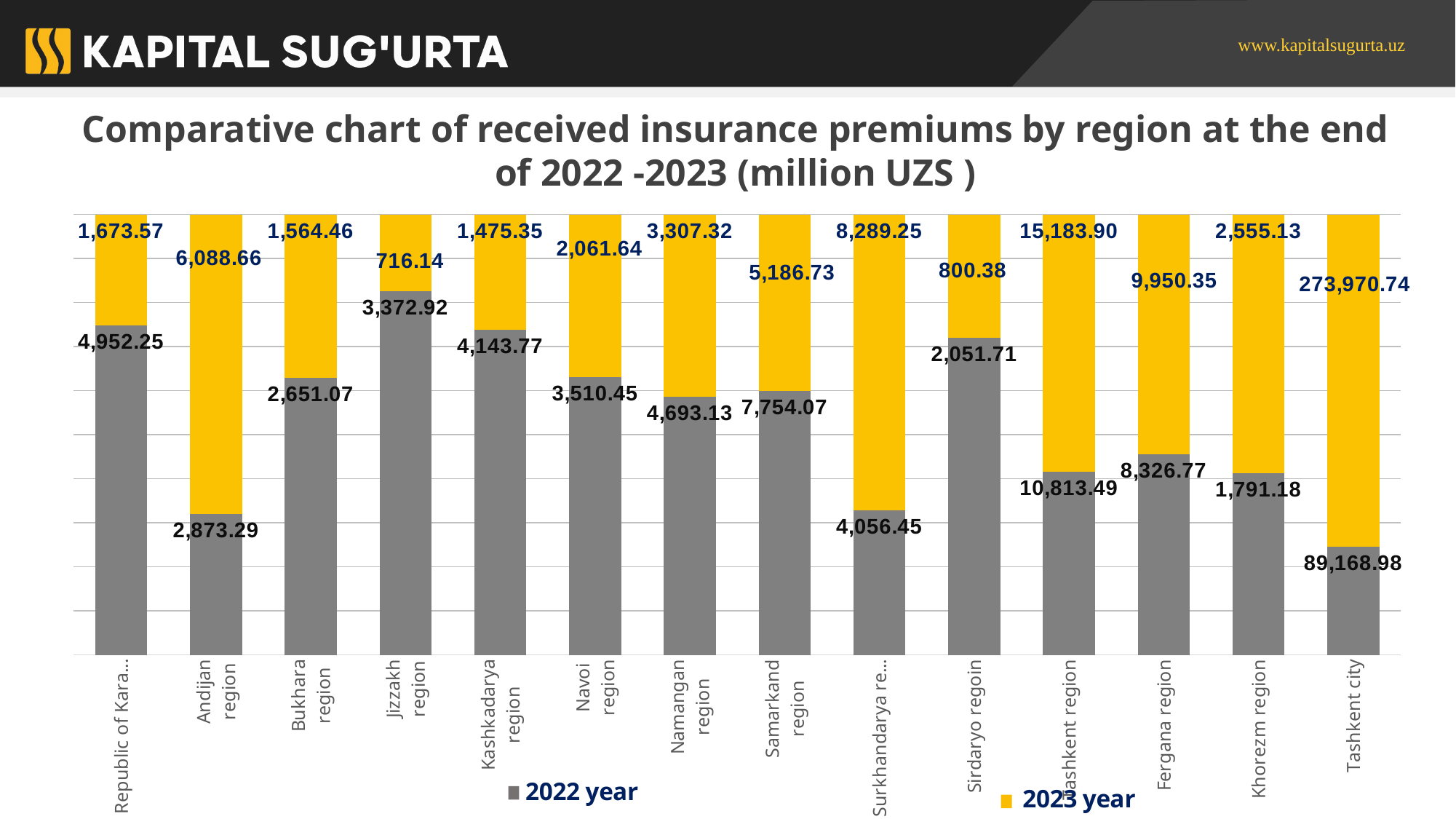
What is the difference between the 2023 year and 2022 year values for Tashkent city? 184,801.76 What was the 2023 year value for Tashkent city? 273,970.74 What is the difference between the 2023 year and 2022 year values for Fergana region? 1,623.58 How many series does the legend list? 2 What type of chart is shown on the slide? Stacked bar chart Which region had the highest 2023 year value? Tashkent city What was the 2023 year value for Jizzakh region? 716.14 Which region had the lowest 2023 year value? Jizzakh region Which region had the lowest 2022 year value? Khorezm region What was the 2022 year value for Tashkent region? 10,813.49 What was the 2022 year value for Samarkand region? 7,754.07 For Andijan region, which is larger: the 2022 year value or the 2023 year value? 2023 year